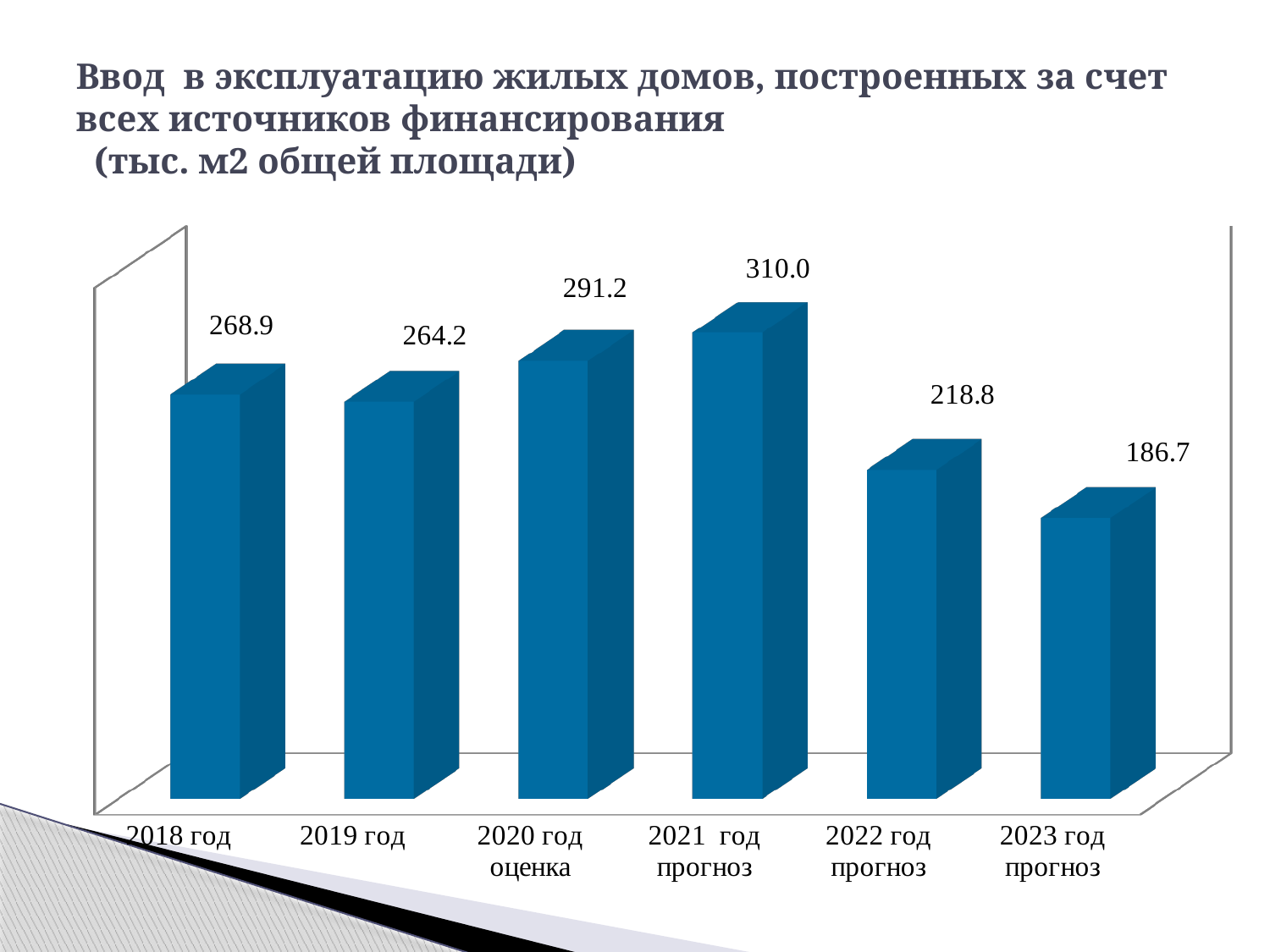
What is the difference between the values for 2018 год and 2019 год? 4.7 What unit is given in the chart title? тыс. м2 общей площади Which year has the lowest value? 2023 год прогноз What kind of chart is shown on the slide? bar chart Which is larger, the value for 2020 год оценка or the value for 2019 год? 2020 год оценка How many years are shown on the chart? 6 What is the value for 2021 год прогноз? 310.0 What is the value for 2018 год? 268.9 What is the difference between the values for 2021 год прогноз and 2022 год прогноз? 91.2 Which year has the highest value? 2021 год прогноз Do the values rise or fall from 2021 год прогноз to 2023 год прогноз? fall What is the value for 2023 год прогноз? 186.7